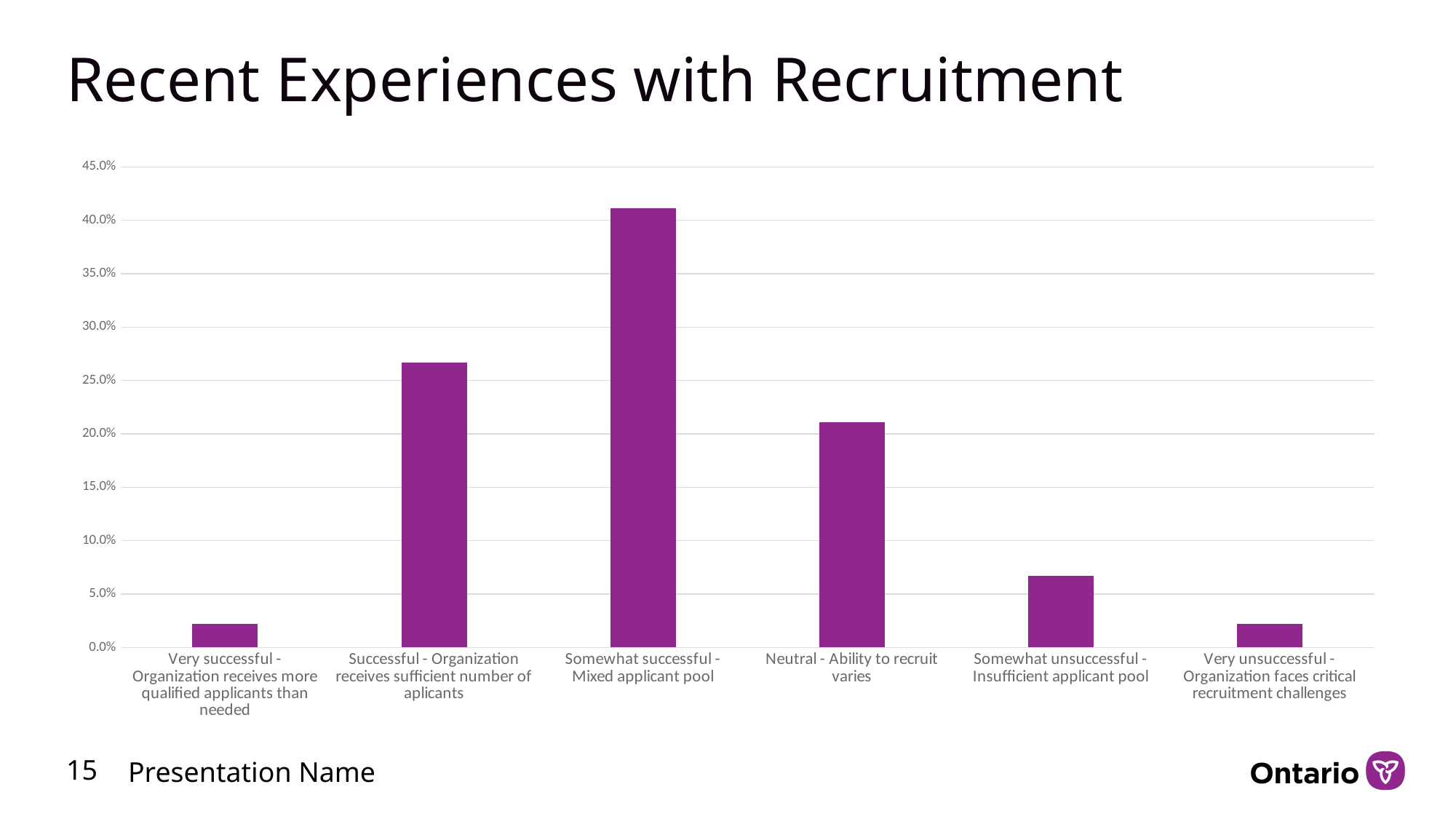
Is the value for "Somewhat unsuccessful - Insufficient applicant pool" greater or less than 10.0%? less Is the value for "Neutral - Ability to recruit varies" greater or less than 15.0%? greater Is the value for "Successful - Organization receives sufficient number of aplicants" greater or less than 30.0%? less What is the title of the chart on the slide? Recent Experiences with Recruitment Which is larger: the value for "Somewhat unsuccessful - Insufficient applicant pool" or the value for "Very unsuccessful - Organization faces critical recruitment challenges"? Somewhat unsuccessful - Insufficient applicant pool How many categories are shown on the x axis of the chart? 6 Which is larger: the value for "Successful - Organization receives sufficient number of aplicants" or the value for "Neutral - Ability to recruit varies"? Successful - Organization receives sufficient number of aplicants Which category has the highest value in the chart? Somewhat successful - Mixed applicant pool What kind of chart is shown on the slide? bar chart What is the highest value shown on the y axis of the chart? 45.0%